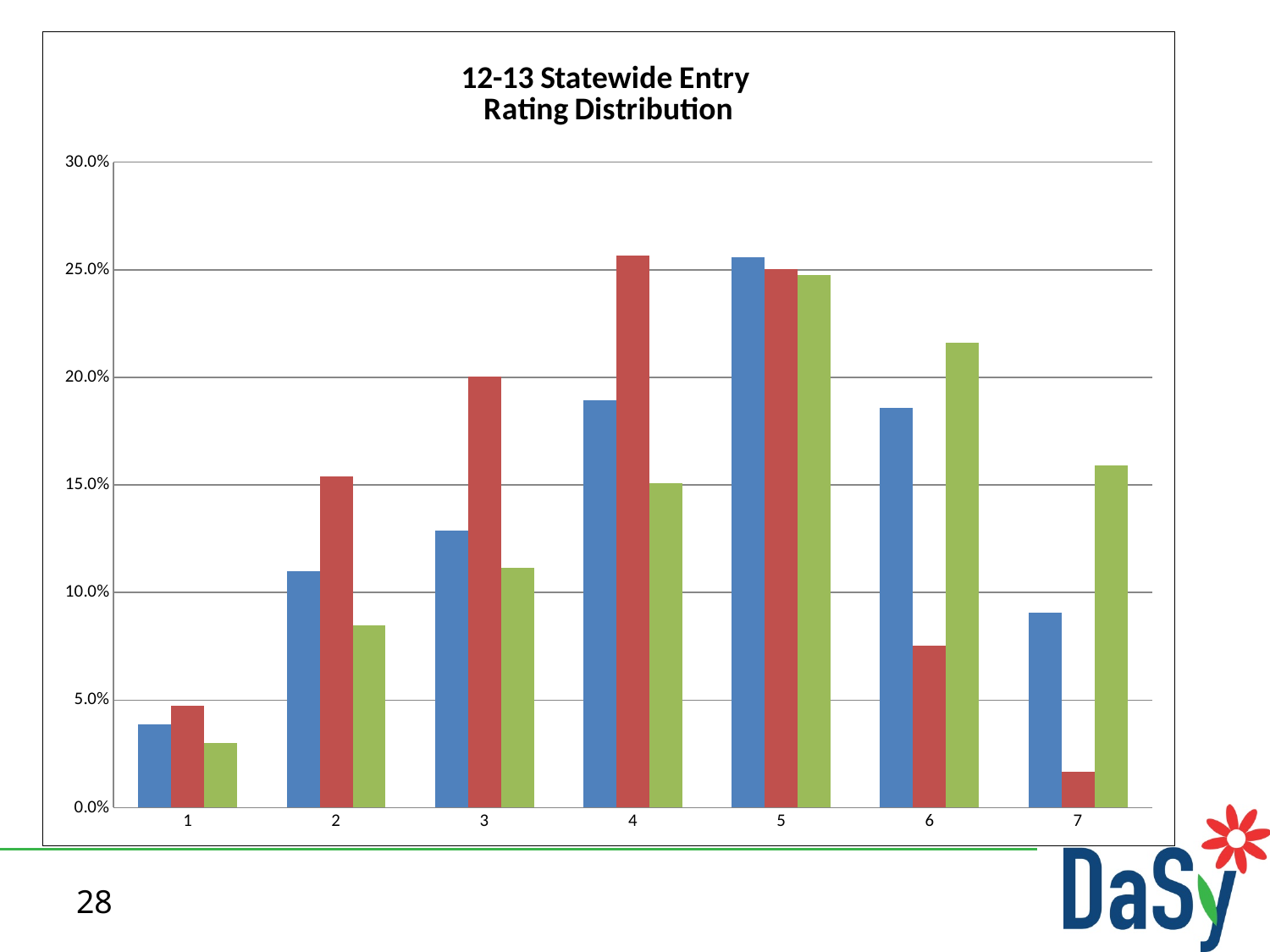
Is the value of the red bar for category 7 greater or less than 5.0%? less For category 6, which is larger, the blue bar or the red bar? blue bar Which category has the lowest red bar? 7 Is the value of the blue bar for category 5 greater or less than 20.0%? greater What kind of chart is shown on the slide? bar chart What is the title of the chart? 12-13 Statewide Entry Rating Distribution How many bars are plotted for each category? 3 Which category has the highest green bar? 5 How many categories are shown on the x axis? 7 Do the blue bars rise or fall from category 1 to category 5? rise Is the value of the blue bar for category 1 greater or less than 5.0%? less